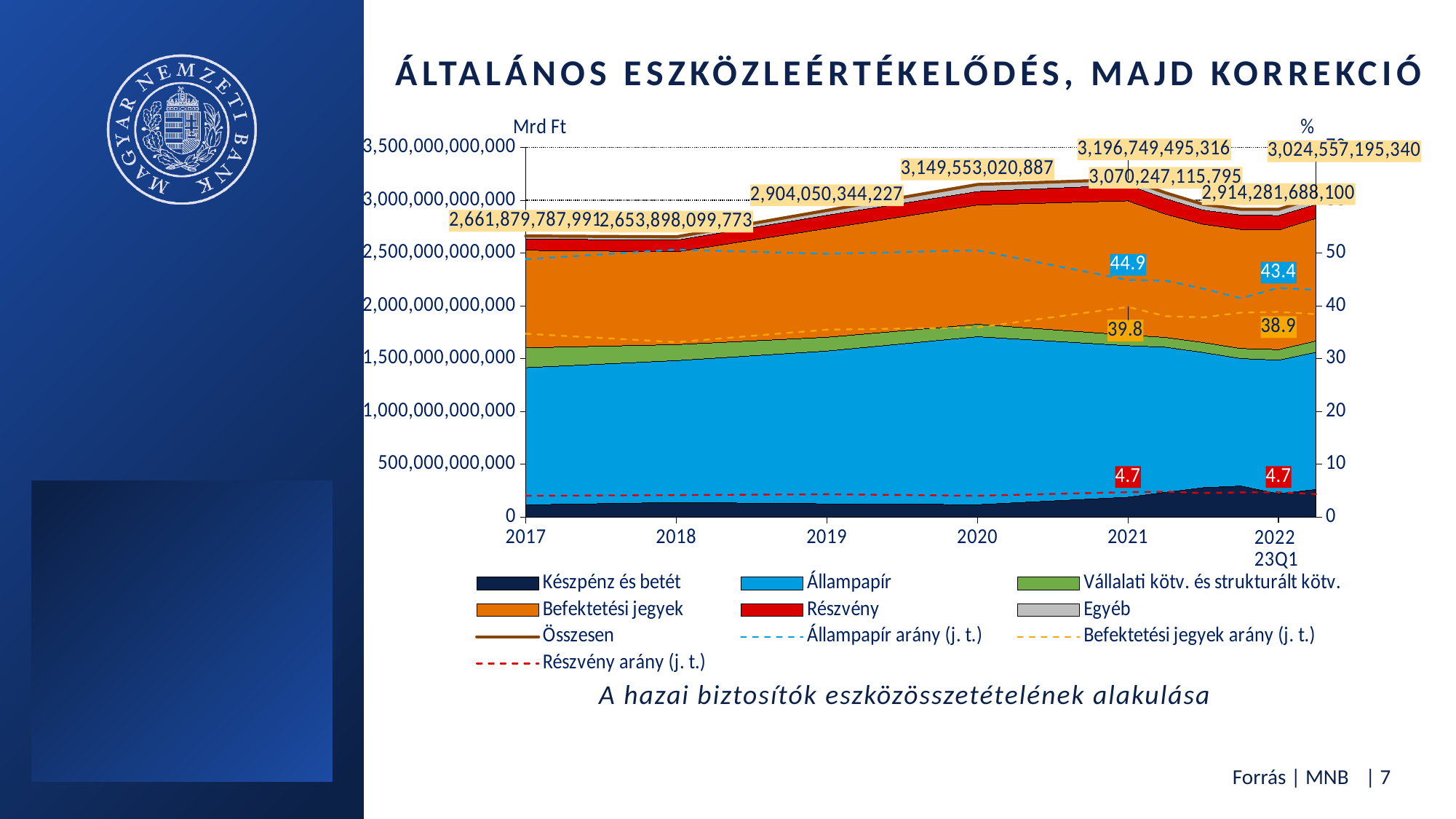
By how much did the Összesen value increase from 2019 to 2020? 245,502,676,660 What is the Összesen value for 2017? 2,661,879,787,991 What is the Befektetési jegyek arány (j. t.) value labelled at 2021? 39.8 What is the Összesen value for 2019? 2,904,050,344,227 What is the Állampapír arány (j. t.) value labelled at 2021? 44.9 By how much did the Összesen value increase from 2018 to 2019? 250,152,244,454 Does the Összesen line rise or fall from 2018 to 2021? rise What is the Összesen value for 2020? 3,149,553,020,887 Which year has the larger Összesen value, 2017 or 2018? 2017 What kind of chart is shown on the slide? combination area and line chart What is the Összesen value for 2018? 2,653,898,099,773 How many series does the legend list? 10